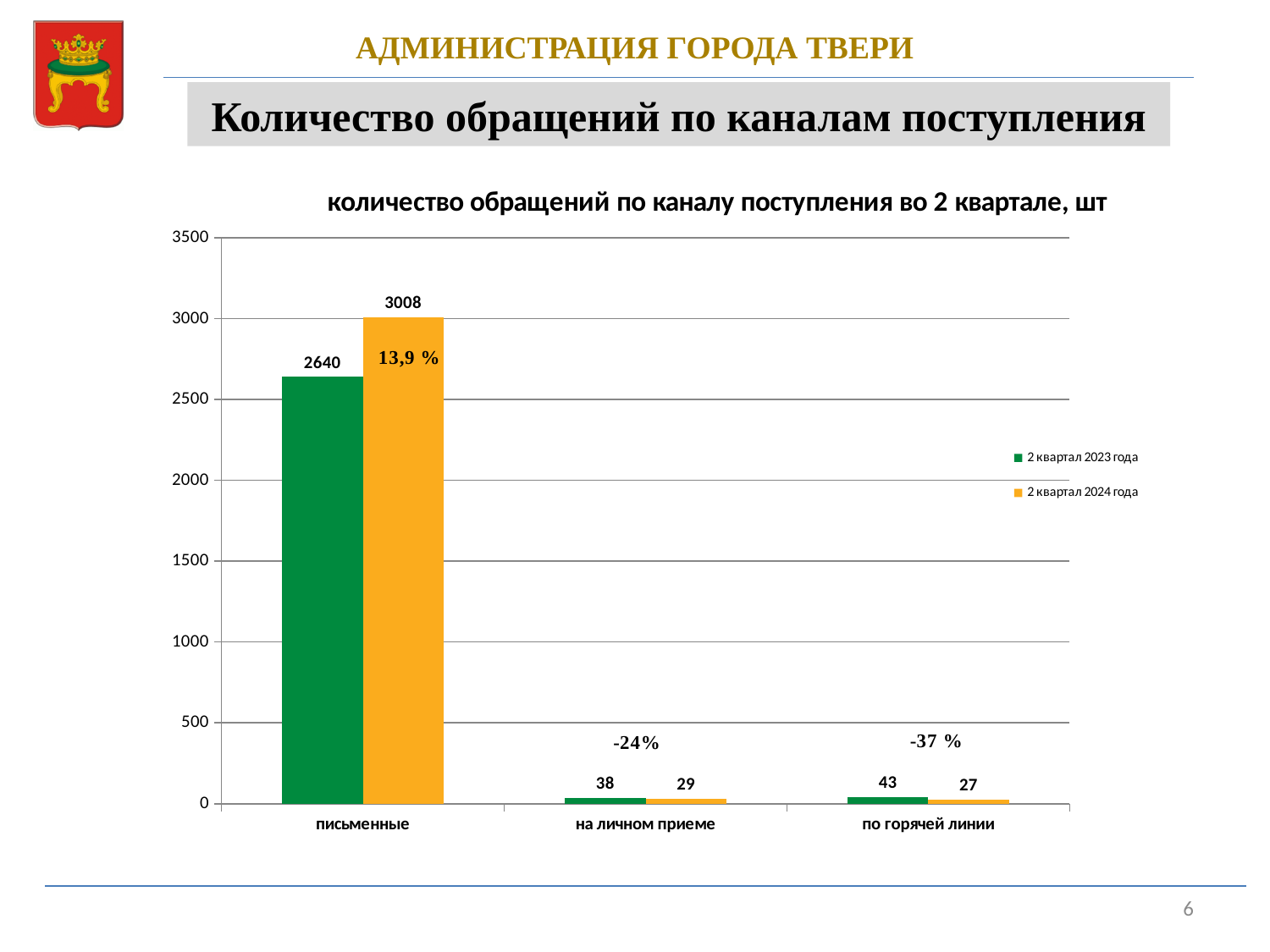
Which is larger for по горячей линии: the 2 квартал 2023 года value or the 2 квартал 2024 года value? 2 квартал 2023 года What kind of chart is shown on the slide? bar chart Which category has the highest value in 2 квартал 2024 года? письменные What is the value for по горячей линии in 2 квартал 2023 года? 43 Is the value for письменные in 2 квартал 2024 года greater or less than 3000? greater Which category has the lowest value in 2 квартал 2023 года? на личном приеме What is the value for письменные in 2 квартал 2023 года? 2640 How many categories are shown on the x axis? 3 What is the difference between the 2 квартал 2024 года and 2 квартал 2023 года values for письменные? 368 How many series does the legend list? 2 What is the value for письменные in 2 квартал 2024 года? 3008 What is the value for на личном приеме in 2 квартал 2024 года? 29